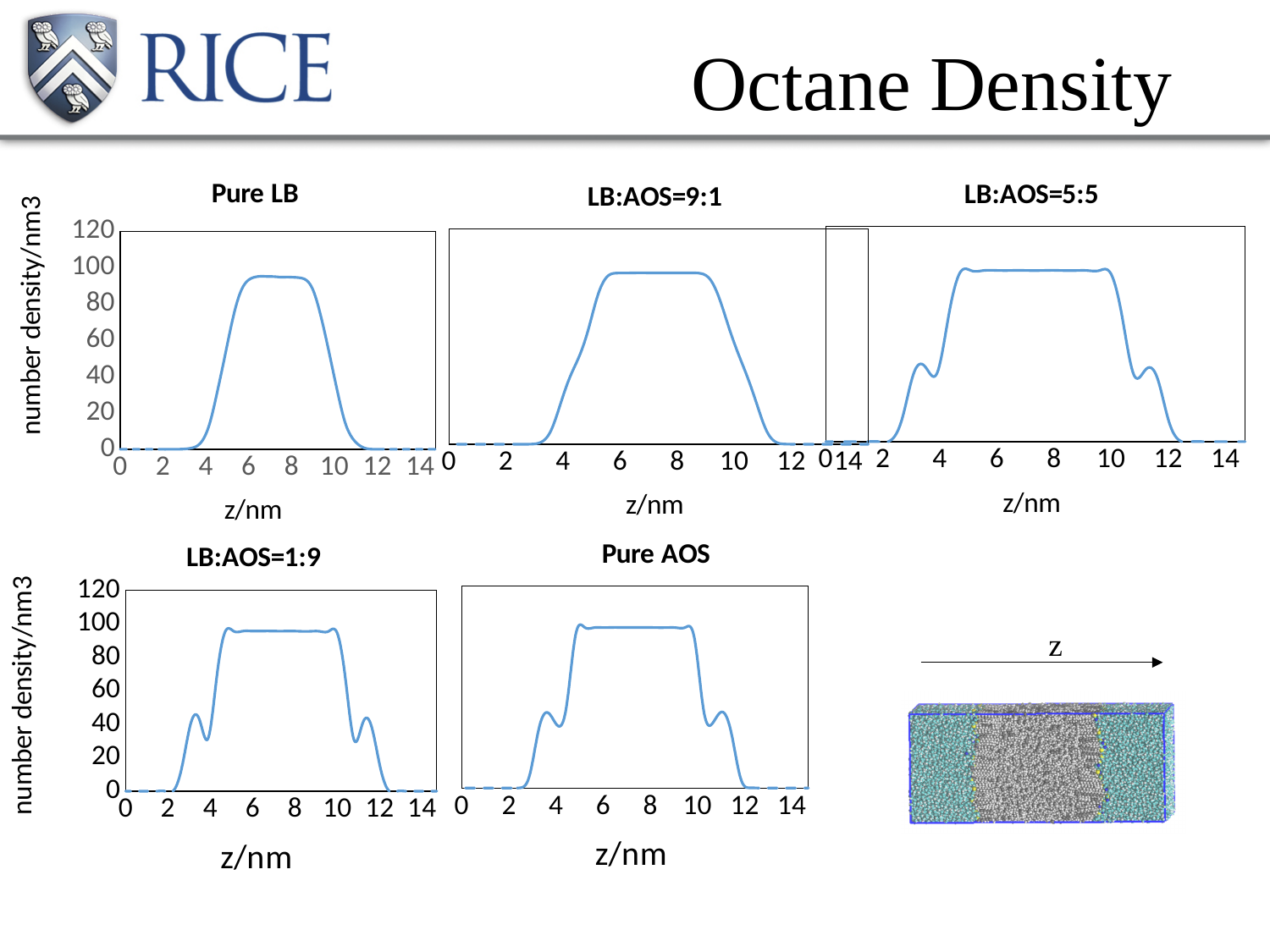
In the 'LB:AOS=9:1' chart, does the number density rise or fall as z goes from 10 nm to 12 nm? fall What kind of chart is the 'Pure LB' chart? line chart In the 'Pure AOS' chart, is the number density at z = 7 nm greater or less than 80? greater What is the x-axis label on the 'Pure AOS' chart? z/nm What is the y-axis label on the 'Pure LB' chart? number density/nm3 How many density charts are shown on the slide? 5 In the 'Pure LB' chart, is the number density at z = 12 nm greater or less than 20? less In the 'LB:AOS=9:1' chart, is the number density at z = 2 nm greater or less than 20? less In the 'Pure LB' chart, does the number density rise or fall as z goes from 4 nm to 6 nm? rise